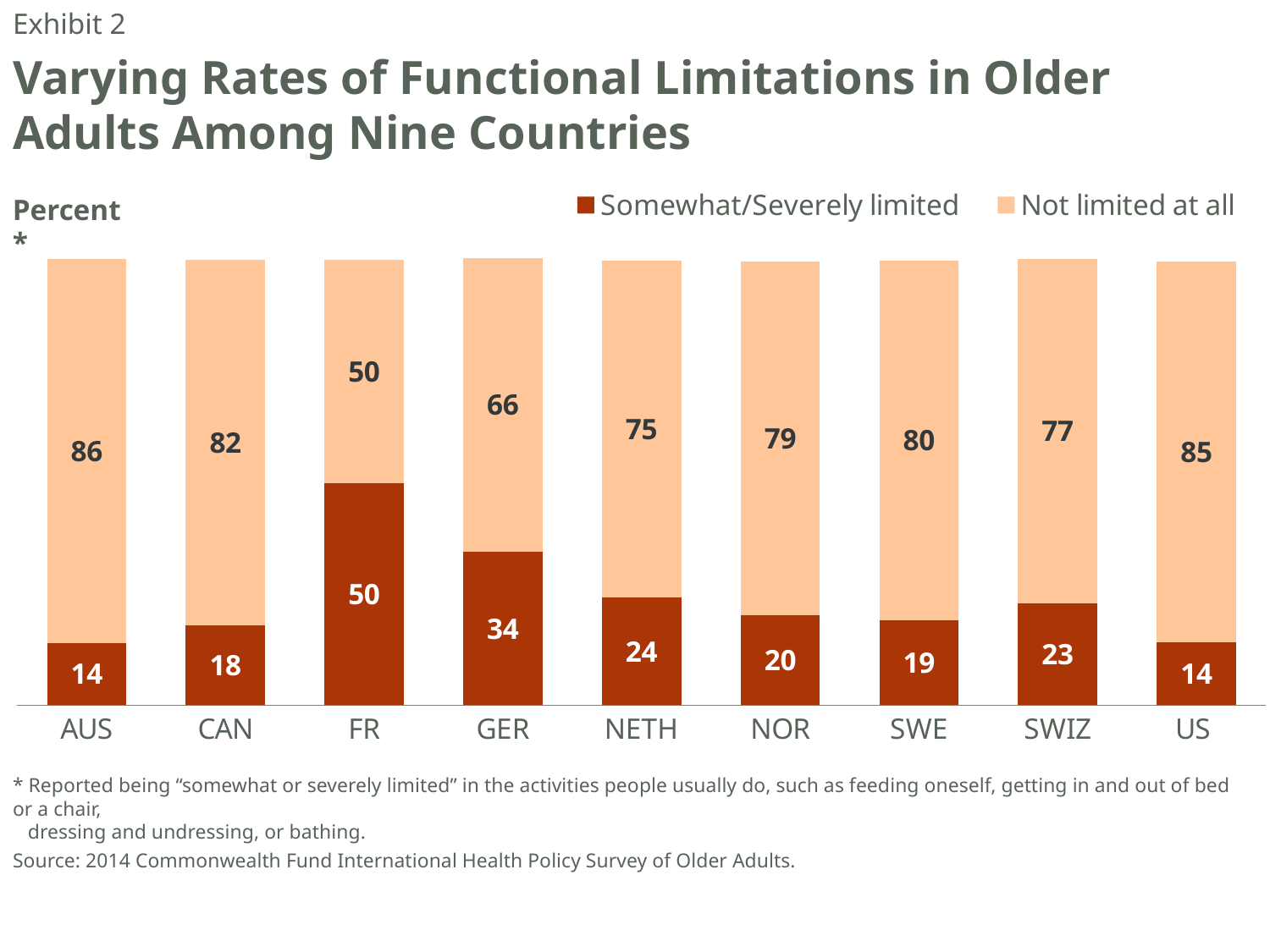
Which country has the lowest value for Not limited at all? FR What is the value for Not limited at all for AUS? 86 What kind of chart is shown on the slide? Stacked bar chart Which legend entry is shown in dark red-brown? Somewhat/Severely limited How many countries are shown on the x axis? 9 How many series does the legend list? 2 Which is larger, the Somewhat/Severely limited value for NETH or for SWE? NETH What is the total of the stacked bar for SWIZ? 100 What is the difference between the Somewhat/Severely limited values for GER and CAN? 16 Which country has the highest value for Somewhat/Severely limited? FR What is the value for Somewhat/Severely limited for GER? 34 What is the value for Somewhat/Severely limited for FR? 50